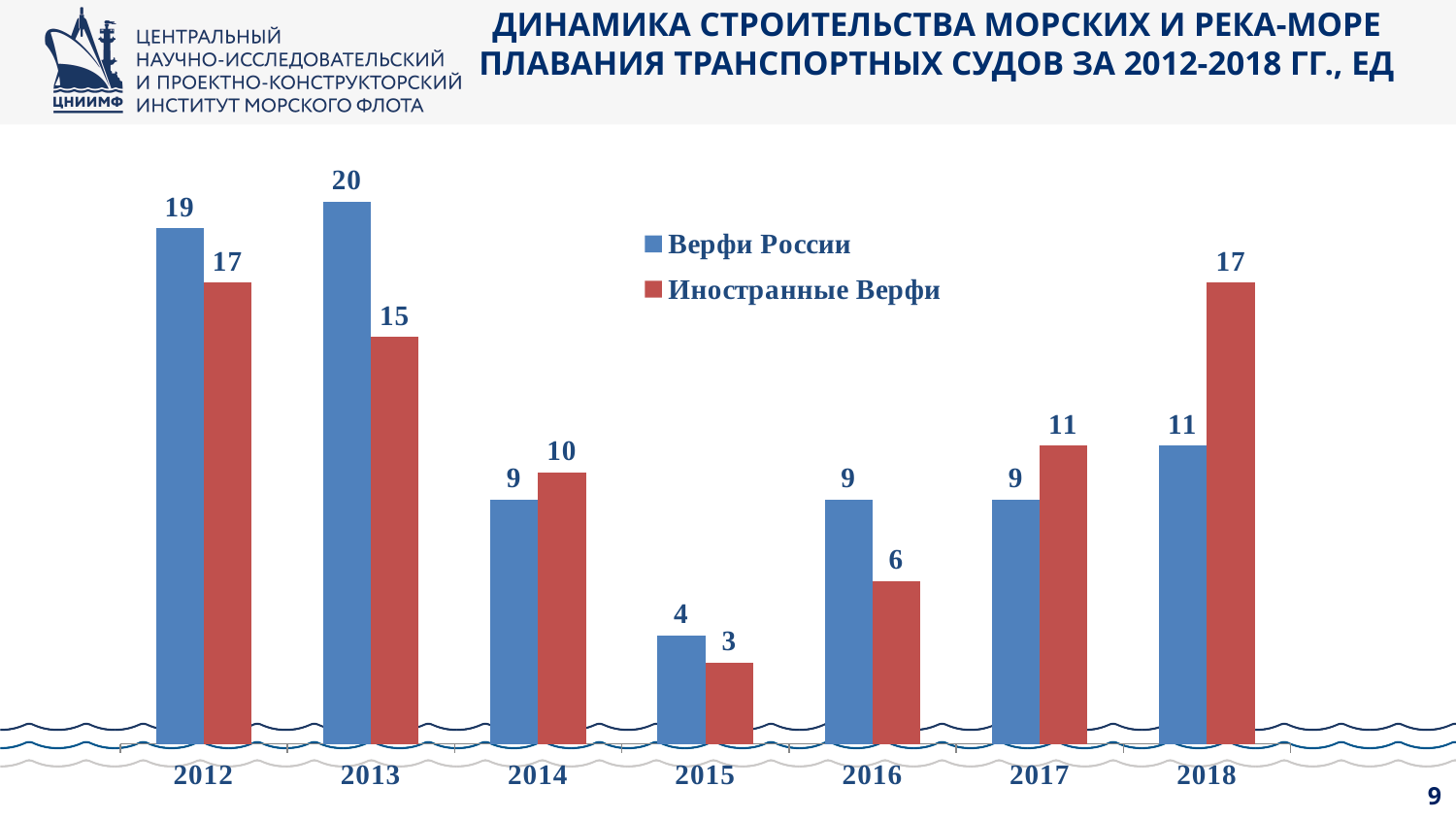
What is the value for Иностранные Верфи in 2015? 3 What is the value for Иностранные Верфи in 2018? 17 In which year is the value for Верфи России highest? 2013 Which colour represents Иностранные Верфи in the legend? red In which year is the value for Иностранные Верфи lowest? 2015 How many series does the legend list? 2 Does the value for Иностранные Верфи rise or fall from 2015 to 2018? rise What is the value for Верфи России in 2013? 20 What is the difference between Верфи России and Иностранные Верфи in 2018? 6 What kind of chart is shown on the slide? bar chart How many years are shown on the x axis? 7 Which is larger in 2016: Верфи России or Иностранные Верфи? Верфи России